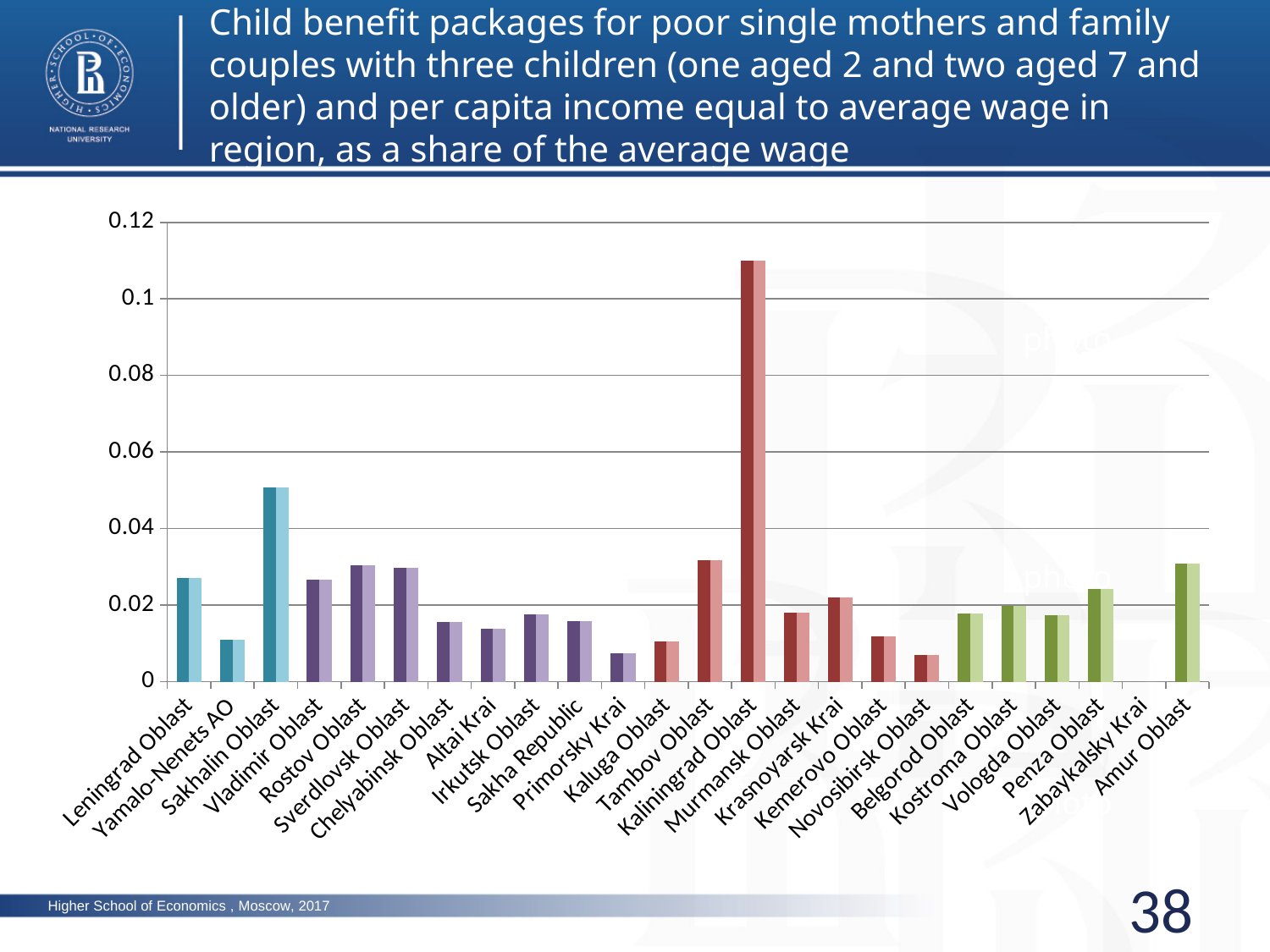
How many regions are shown on the x axis of the chart? 24 What kind of chart is shown on the slide? bar chart Is the value for Sakhalin Oblast greater or less than 0.04? greater What is the highest tick value shown on the vertical axis of the chart? 0.12 Which is larger, the value for Leningrad Oblast or the value for Yamalo-Nenets AO? Leningrad Oblast Is the value for Kaliningrad Oblast greater or less than 0.1? greater Which region has the lowest value in the chart? Zabaykalsky Krai Which region has the highest value in the chart? Kaliningrad Oblast Which is larger, the value for Sakhalin Oblast or the value for Tambov Oblast? Sakhalin Oblast Is the value for Tambov Oblast greater or less than 0.02? greater